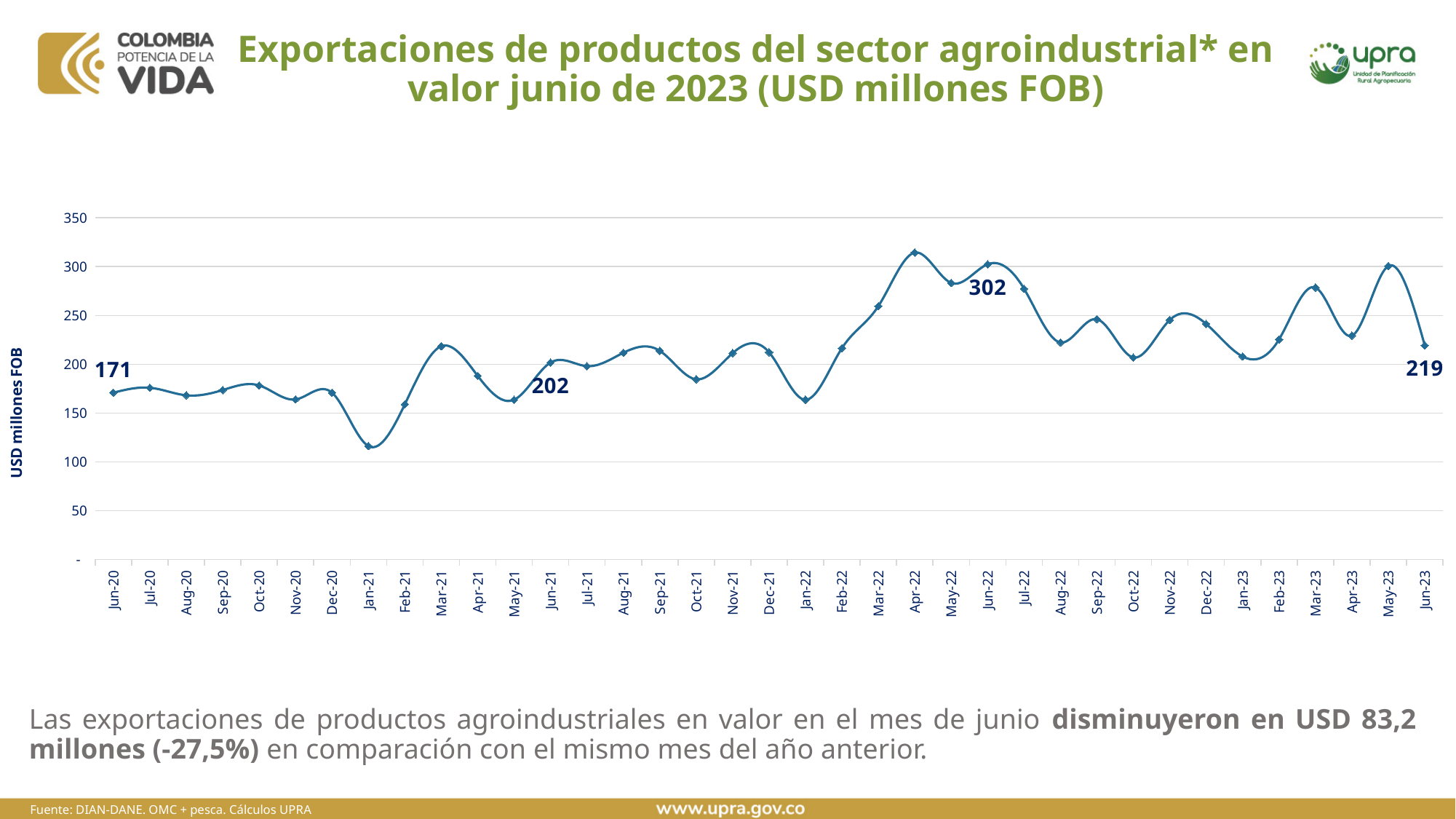
What is the value for Jun-20? 171 Is the value for Jan-21 greater or less than 150? less What kind of chart is shown on the slide? line chart What is the difference between the values for Jun-22 and Jun-23? 83 What is the value for Jun-23? 219 What is the difference between the values for Jun-21 and Jun-20? 31 Which month has the highest value on the chart? Apr-22 Which month has the lowest value on the chart? Jan-21 What is the value for Jun-22? 302 How many monthly data points are plotted on the chart? 37 Which is larger, the value for Jun-22 or the value for Jun-23? Jun-22 What is the value for Jun-21? 202